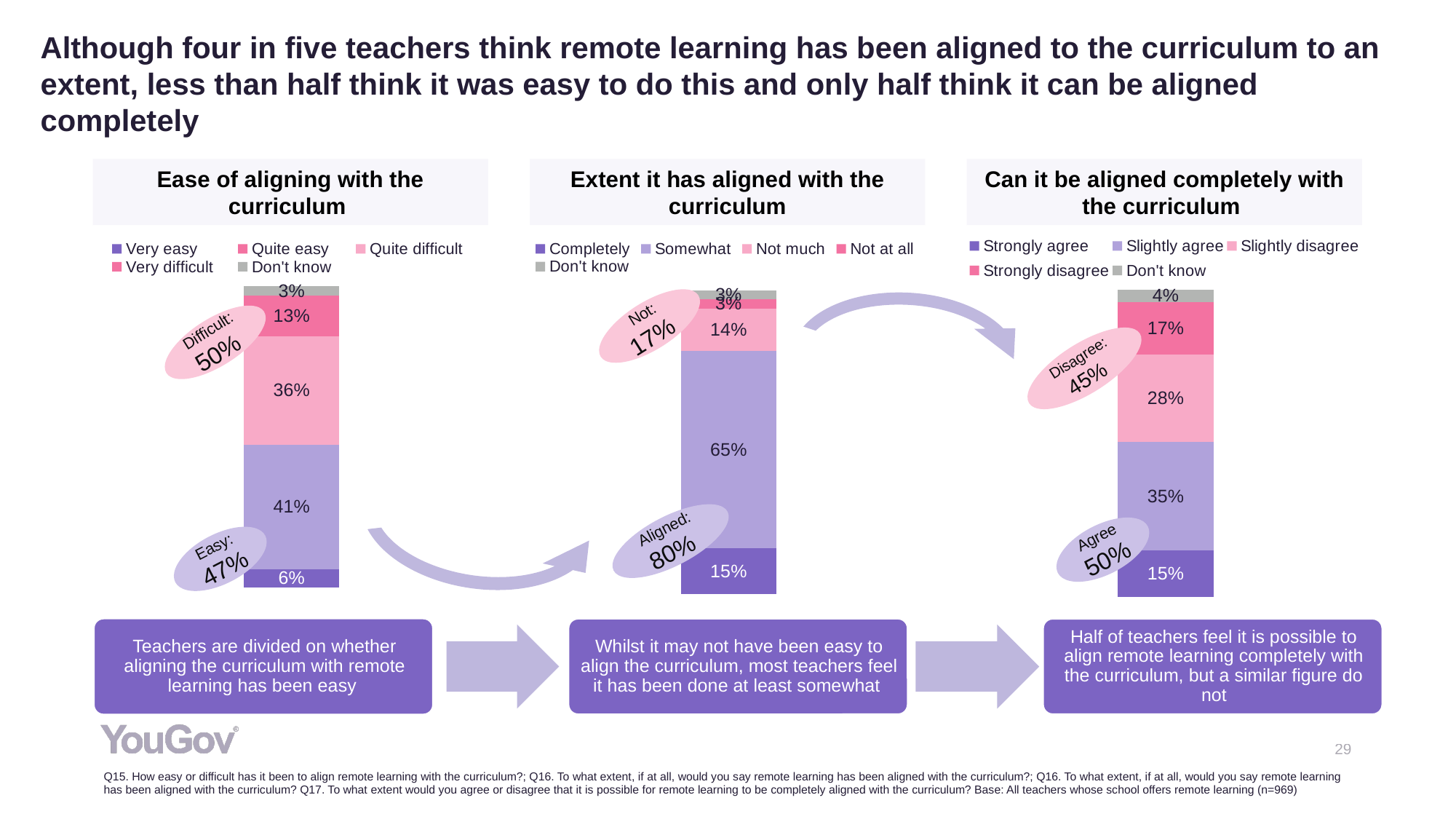
In the 'Can it be aligned completely with the curriculum' chart, what percentage said 'Slightly disagree'? 28% In the 'Extent it has aligned with the curriculum' chart, which response has the largest share? Somewhat What type of chart is used for 'Extent it has aligned with the curriculum'? Stacked bar chart In the 'Extent it has aligned with the curriculum' chart, what percentage said 'Somewhat'? 65% In the 'Ease of aligning with the curriculum' chart, which response has the smallest share? Don't know In the 'Can it be aligned completely with the curriculum' chart, what is the combined share of 'Strongly agree' and 'Slightly agree'? 50% In the 'Can it be aligned completely with the curriculum' chart, which is larger: 'Slightly agree' or 'Strongly disagree'? Slightly agree In the 'Ease of aligning with the curriculum' chart, what percentage said 'Very difficult'? 13% In the 'Ease of aligning with the curriculum' chart, what is the combined share of 'Quite difficult' and 'Very difficult'? 49% In the 'Ease of aligning with the curriculum' chart, what percentage of teachers said 'Quite easy'? 41% How many entries does the legend of the 'Ease of aligning with the curriculum' chart list? 5 In the 'Extent it has aligned with the curriculum' chart, what is the difference between 'Somewhat' and 'Completely'? 50 percentage points